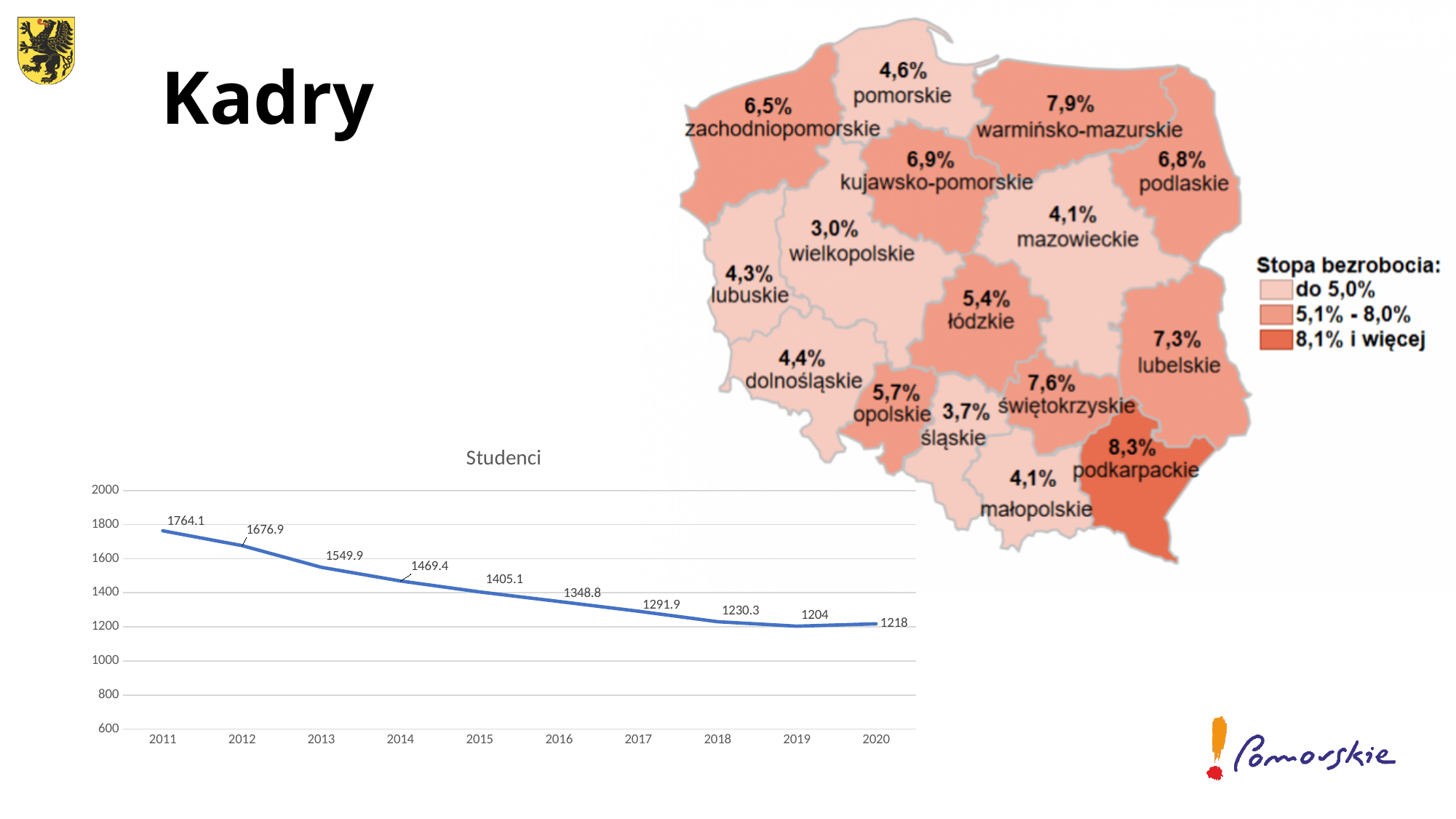
How many years are plotted in the Studenci chart? 10 In the Studenci chart, what is the difference between the values for 2011 and 2012? 87.2 In the Studenci chart, which year has the highest value? 2011 In the Studenci chart, what is the value for 2020? 1218 What type of chart is the Studenci chart? line chart In the Studenci chart, how much higher is the value for 2020 than for 2019? 14 In the Studenci chart, do the values generally rise or fall from 2011 to 2019? fall In the Studenci chart, is the value for 2014 greater or less than 1400? greater In the Studenci chart, which is larger: the value for 2013 or the value for 2015? 2013 In the Studenci chart, which year has the lowest value? 2019 In the Studenci chart, what is the value for 2016? 1348.8 In the Studenci chart, what is the value for 2011? 1764.1